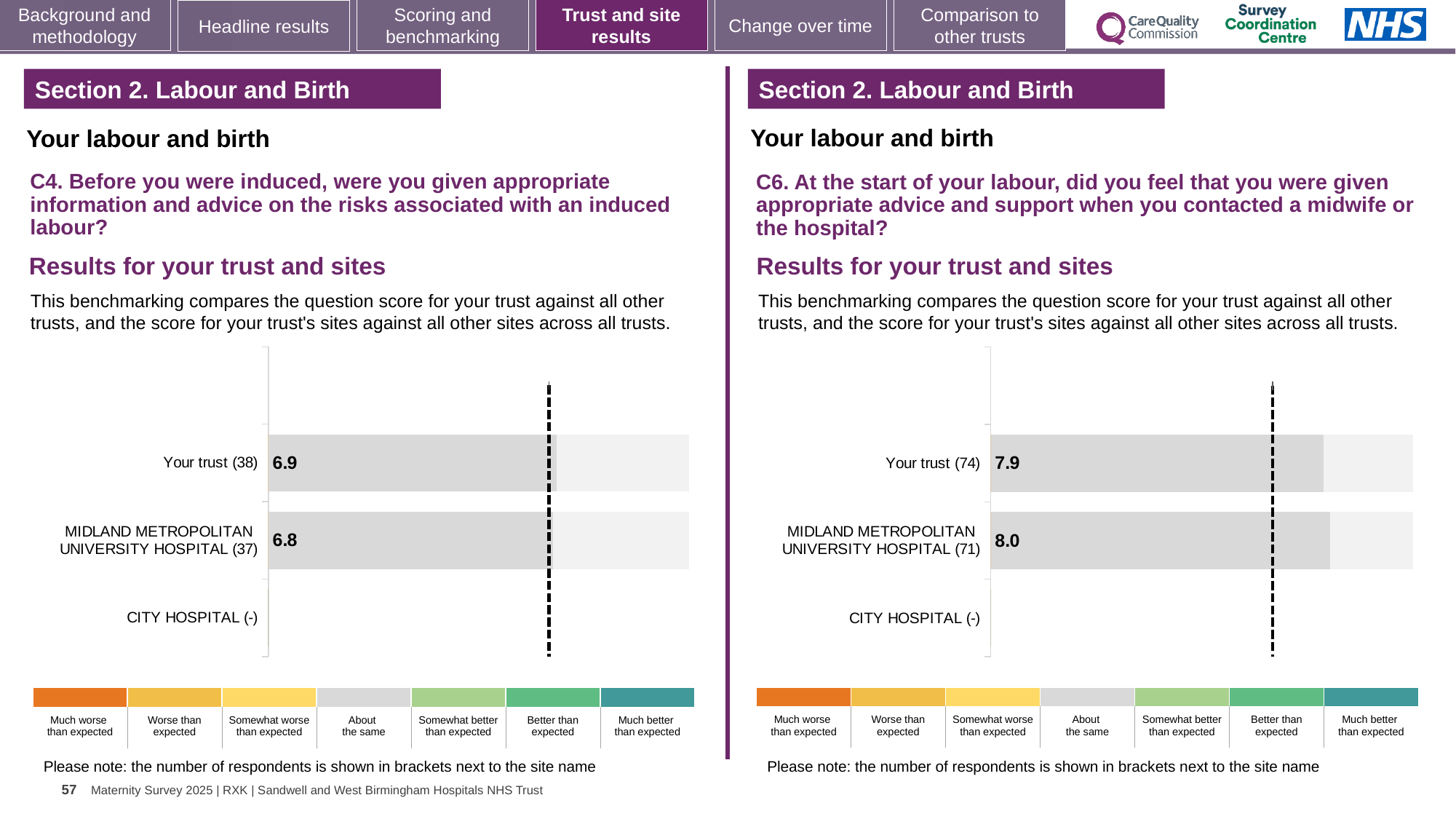
On the C6 chart (right), how many respondents are shown in brackets for Midland Metropolitan University Hospital? 71 On the C4 chart (left), what is the difference between the score for Your trust and the score for Midland Metropolitan University Hospital? 0.1 How many categories (rows) are listed on the C4 chart (left)? 3 On the C6 chart (right), what is the difference between the score for Midland Metropolitan University Hospital and the score for Your trust? 0.1 On the C6 chart (right), what is the score for Your trust? 7.9 On the C4 chart (left), what is the score for Midland Metropolitan University Hospital? 6.8 On the C6 chart (right), what is the score for Midland Metropolitan University Hospital? 8.0 On the C4 chart (left), what is the score for Your trust? 6.9 On the C4 chart (left), which has the higher score: Your trust or Midland Metropolitan University Hospital? Your trust What kind of chart is used on the C6 chart (right)? Bar chart On the C4 chart (left), how many respondents are shown in brackets for Your trust? 38 On the C6 chart (right), which has the higher score: Your trust or Midland Metropolitan University Hospital? Midland Metropolitan University Hospital